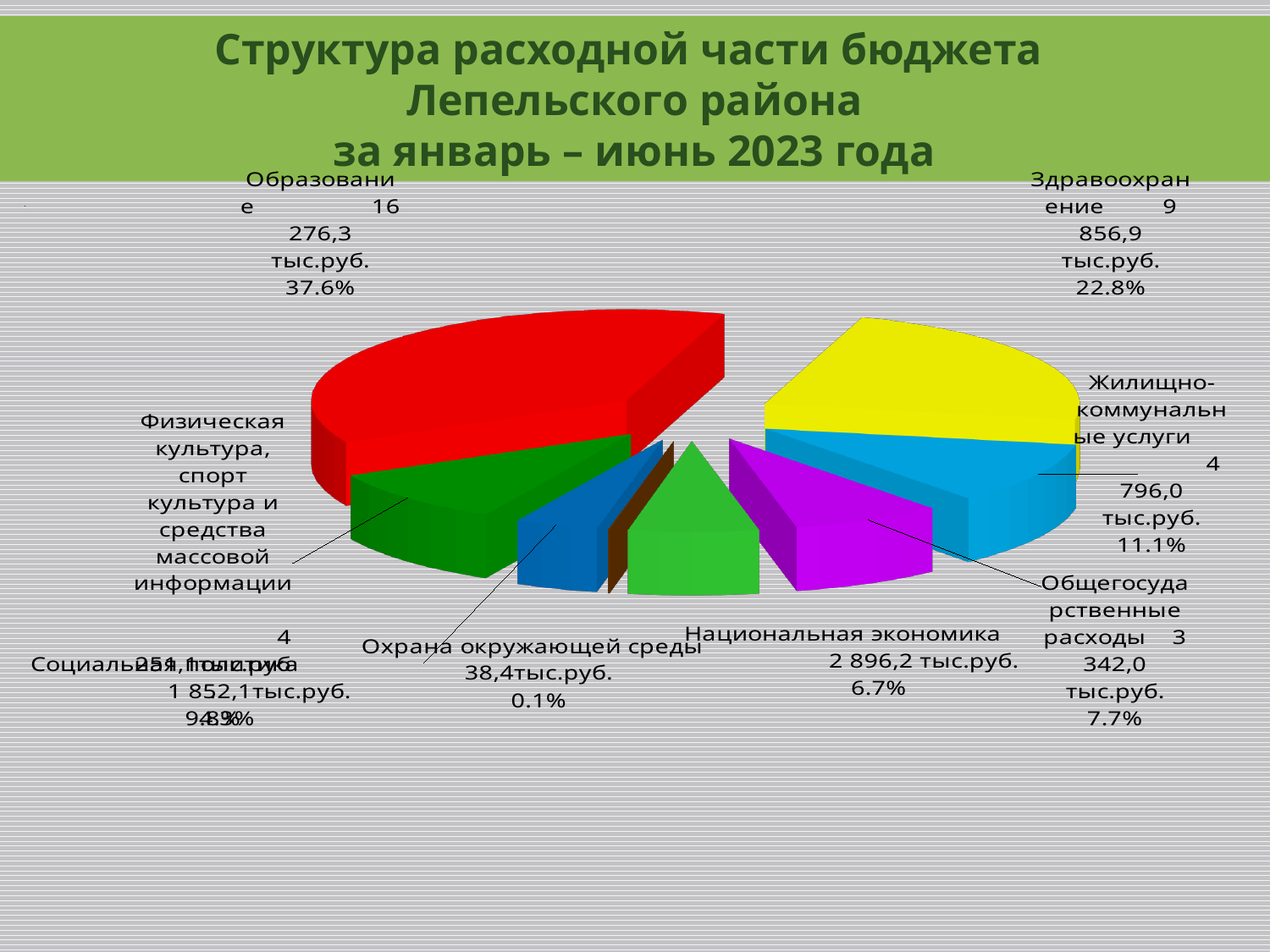
Which category has the largest share of the budget expenditure? Образование What is the value shown for Охрана окружающей среды? 38,4 тыс.руб. By how many percentage points does the share of Образование exceed the share of Здравоохранение? 14.8% How many categories (slices) does the pie chart have? 8 Which is larger: Жилищно-коммунальные услуги or Общегосударственные расходы? Жилищно-коммунальные услуги What share of the pie does Здравоохранение represent? 22.8% What is the value shown for Здравоохранение? 9 856,9 тыс.руб. What share of the pie does Национальная экономика represent? 6.7% What share of the budget expenditure does Образование account for? 37.6% Which category has the smallest share of the budget expenditure? Охрана окружающей среды What is the value shown for Образование? 16 276,3 тыс.руб. What kind of chart is shown on the slide? pie chart